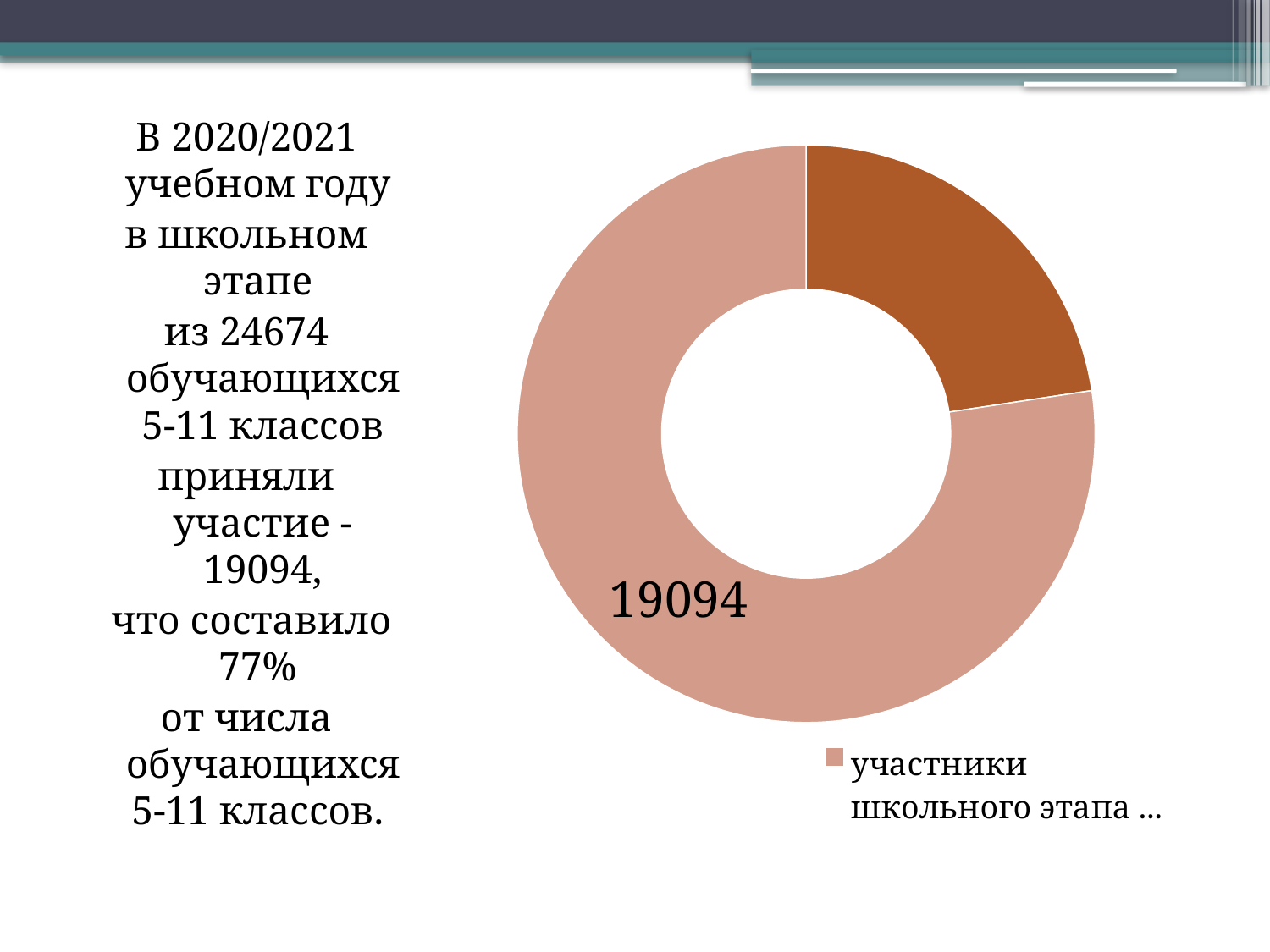
Which slice of the doughnut chart is the smallest? the dark orange slice How many slices does the doughnut chart have? 2 What kind of chart is shown on the slide? doughnut (pie) chart What colour is the slice that carries the data label 19094? light pink Does the dark orange slice of the doughnut chart have a data label printed on it? No Is the value printed on the large slice of the doughnut chart greater or less than 15000? greater Which slice of the doughnut chart is larger, the light pink slice or the dark orange slice? the light pink slice Which slice of the doughnut chart is the largest? the light pink slice labelled 19094 What value is printed on the large light-coloured slice of the doughnut chart? 19094 According to the slide, what share of the 24674 students does the 19094 slice represent? 77% How many entries does the chart legend list? 1